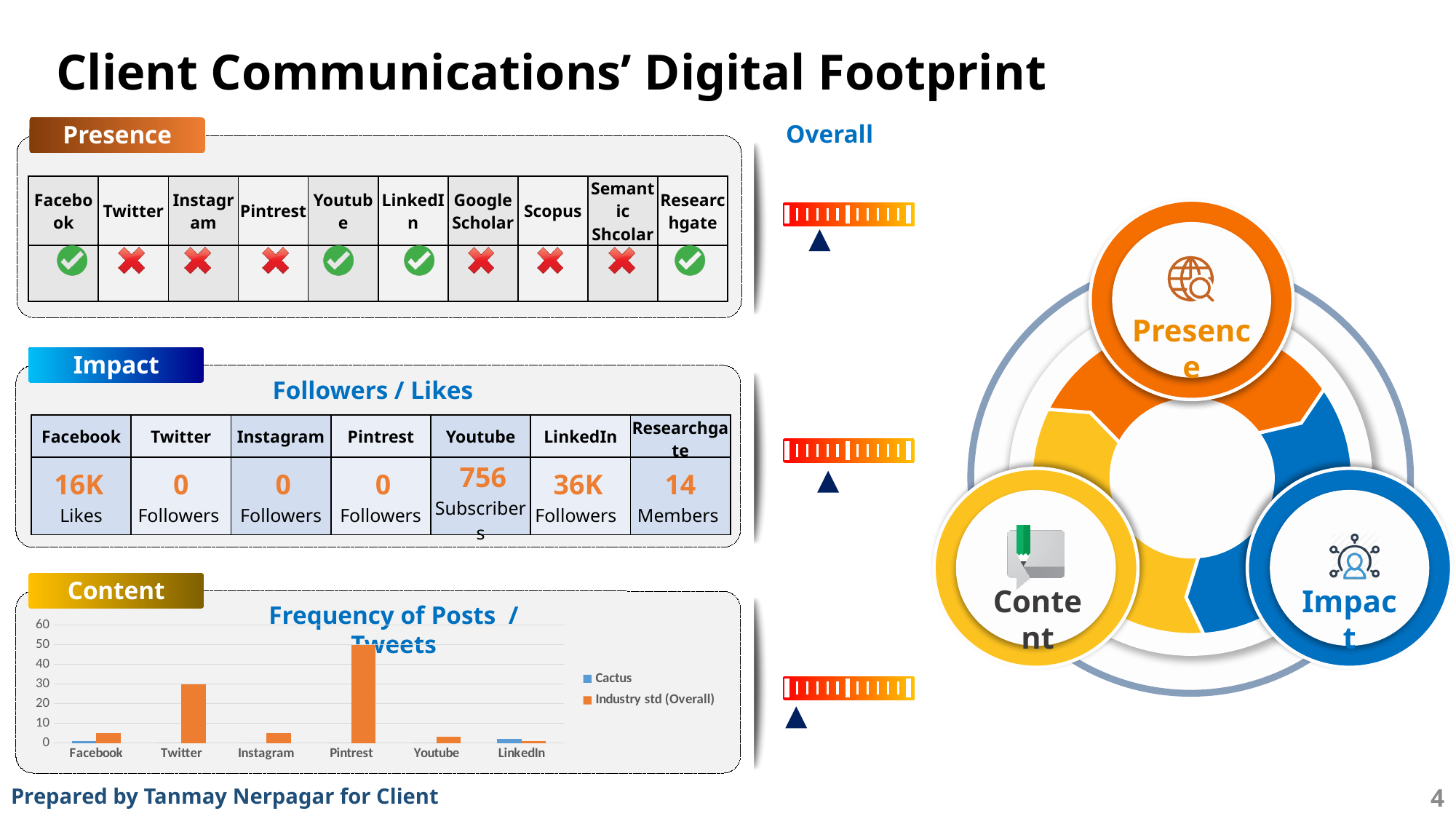
In the "Frequency of Posts / Tweets" chart, what colour are the Industry std (Overall) bars? orange In the "Frequency of Posts / Tweets" chart, is the Industry std (Overall) value for Pintrest greater or less than 40? greater In the "Frequency of Posts / Tweets" chart, is the Cactus value for Twitter greater or less than 10? less In the "Frequency of Posts / Tweets" chart, which platform has the highest Industry std (Overall) value? Pintrest What are the two series named in the legend of the "Frequency of Posts / Tweets" chart? Cactus and Industry std (Overall) In the "Frequency of Posts / Tweets" chart, which is larger for Industry std (Overall): Pintrest or Youtube? Pintrest In the "Frequency of Posts / Tweets" chart, is the Industry std (Overall) value for Twitter greater or less than 20? greater What kind of chart is the "Frequency of Posts / Tweets" chart? bar chart How many platform categories are shown on the x axis of the "Frequency of Posts / Tweets" chart? 6 How many series does the legend of the "Frequency of Posts / Tweets" chart list? 2 In the "Frequency of Posts / Tweets" chart, which is larger for Industry std (Overall): Twitter or Instagram? Twitter